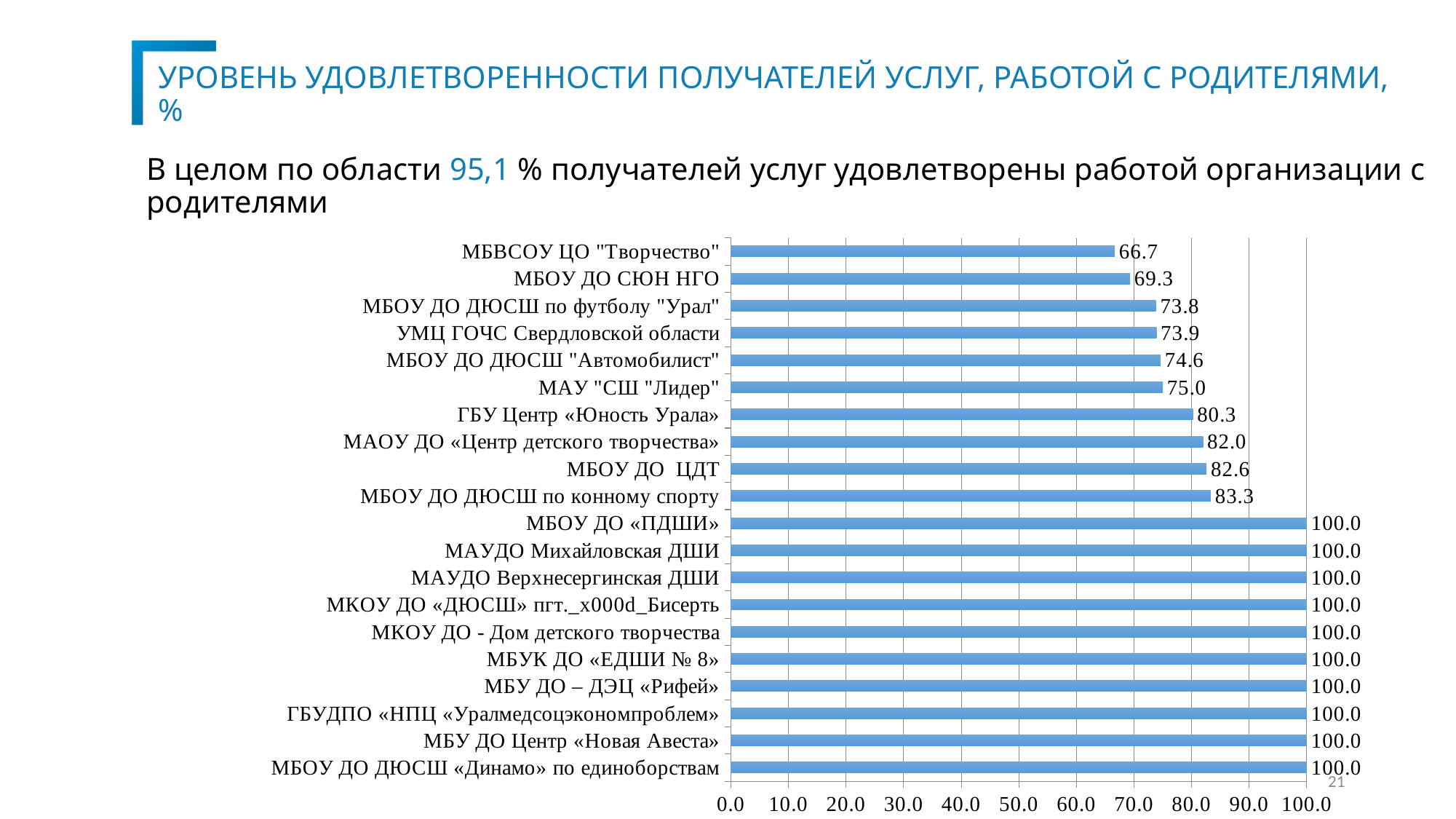
What is the value for МБОУ ДО ДЮСШ по конному спорту? 83.3 Is the value for МБОУ ДО ДЮСШ по футболу "Урал" greater or less than 70.0? greater Which is larger: the value for МБОУ ДО СЮН НГО or the value for МБОУ ДО ДЮСШ "Автомобилист"? МБОУ ДО ДЮСШ "Автомобилист" How many organisations have a value of 100.0? 10 What is the value for ГБУ Центр «Юность Урала»? 80.3 Which organisation has the lowest value in the chart? МБВСОУ ЦО "Творчество" What kind of chart is shown on the slide? bar chart What is the value for МАУ "СШ "Лидер"? 75.0 What is the difference between the value for МБОУ ДО «ПДШИ» and the value for МБВСОУ ЦО "Творчество"? 33.3 What is the difference between the value for МБОУ ДО ЦДТ and the value for МАОУ ДО «Центр детского творчества»? 0.6 How many organisations (categories) are plotted in the chart? 20 What is the value for МБВСОУ ЦО "Творчество"? 66.7